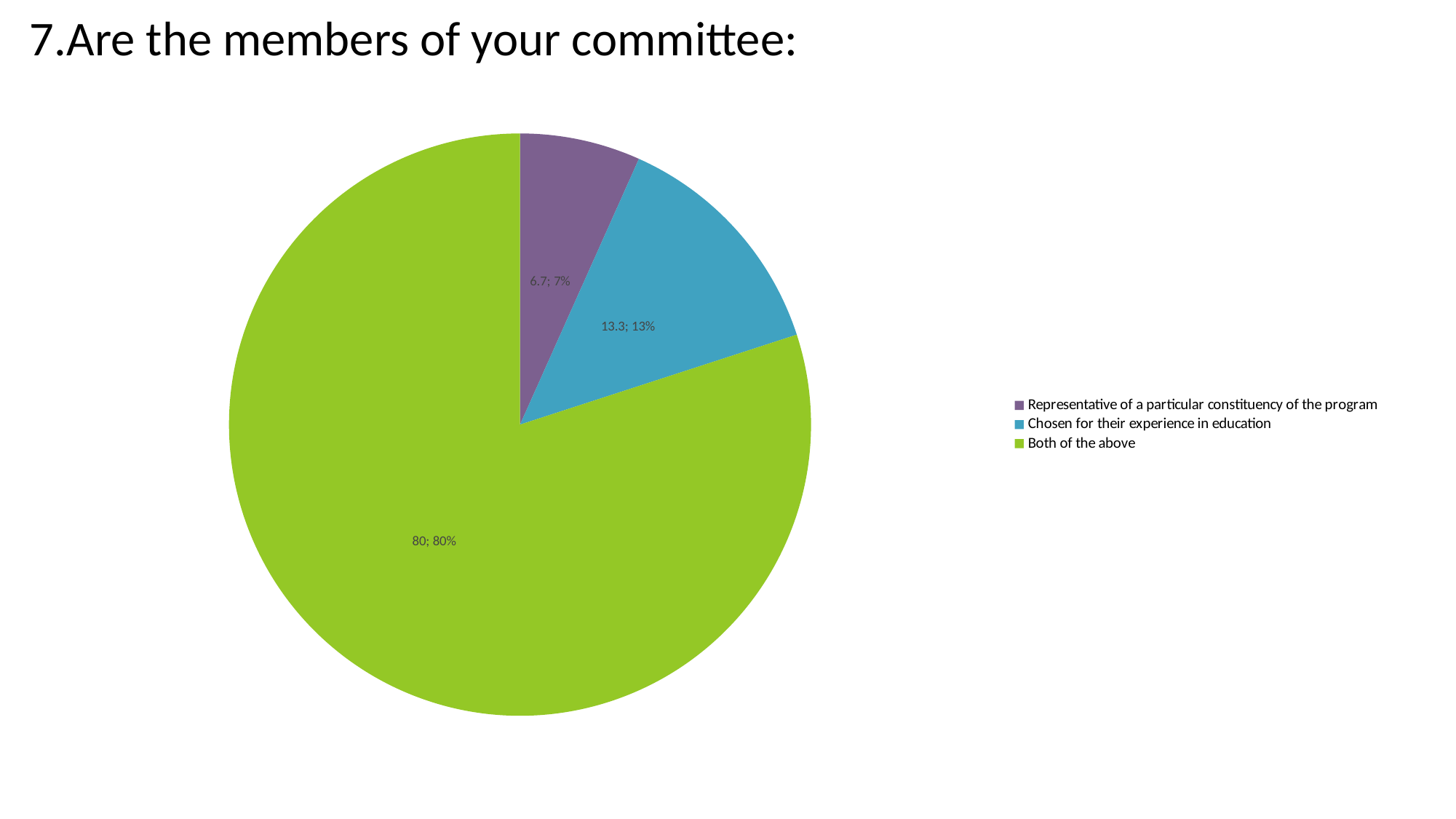
What kind of chart is shown on the slide? Pie chart What percentage share of the pie does 'Both of the above' represent? 80% Which category has the largest slice of the pie? Both of the above How many entries does the legend list? 3 Which category has the smallest slice of the pie? Representative of a particular constituency of the program How many slices does the pie chart have? 3 What is the difference between the values for 'Both of the above' and 'Chosen for their experience in education'? 66.7 What percentage share of the pie does 'Chosen for their experience in education' represent? 13% What value is shown for the 'Both of the above' slice? 80 What value is shown for the 'Chosen for their experience in education' slice? 13.3 What value is shown for the 'Representative of a particular constituency of the program' slice? 6.7 Which is larger: the value for 'Chosen for their experience in education' or for 'Representative of a particular constituency of the program'? Chosen for their experience in education